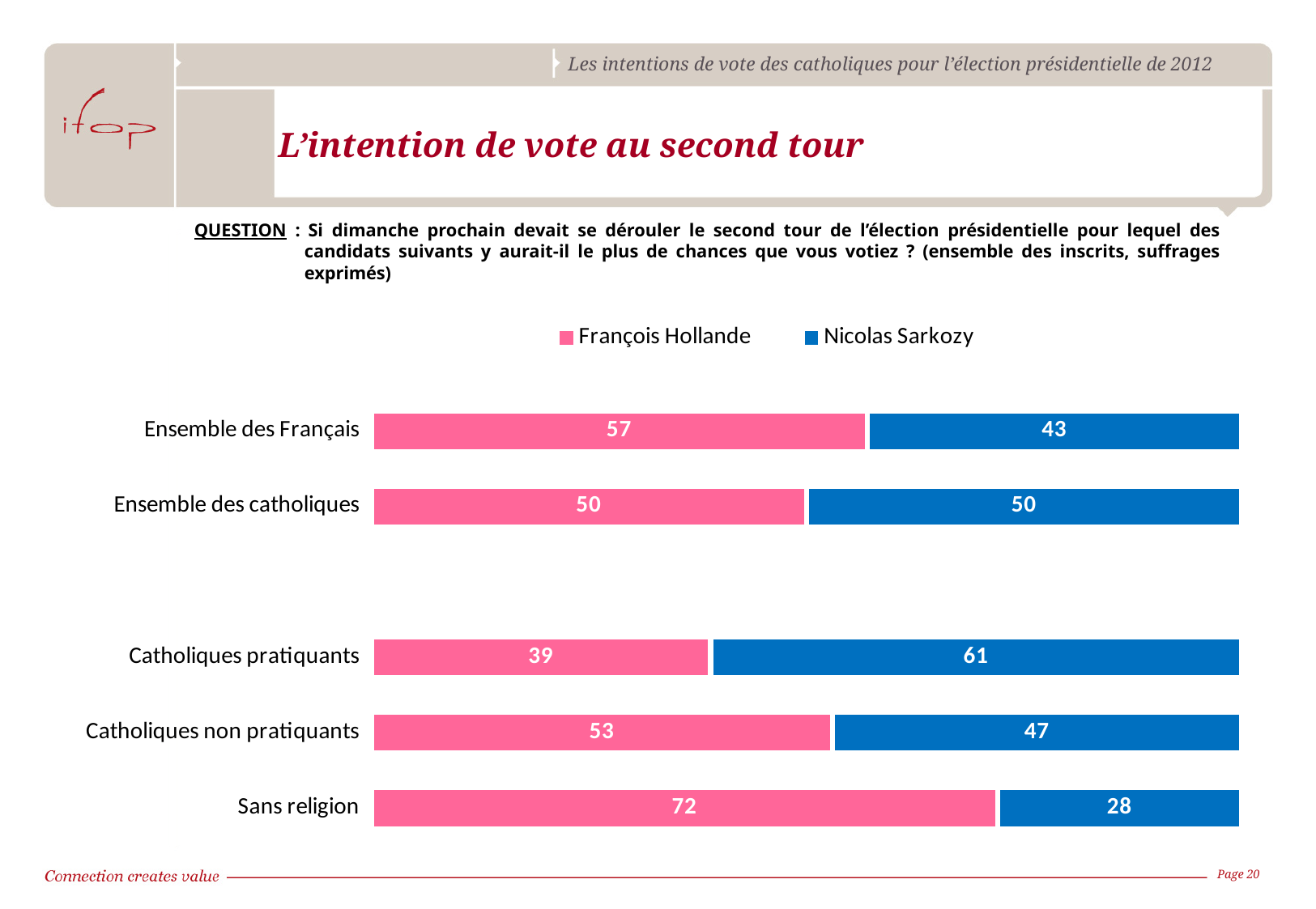
What is the value for Nicolas Sarkozy among Catholiques non pratiquants? 47 What is the total of the stacked bar for Catholiques non pratiquants? 100 What is the difference between Nicolas Sarkozy and François Hollande among Catholiques pratiquants? 22 How many series does the legend list? 2 What is the value for François Hollande among Ensemble des Français? 57 What kind of chart is shown on the slide? Stacked bar chart Which category has the lowest value for Nicolas Sarkozy? Sans religion How many categories are shown in the chart? 5 What is the value for Nicolas Sarkozy among Catholiques pratiquants? 61 What is the value for François Hollande among Sans religion? 72 Which category has the highest value for François Hollande? Sans religion Among Ensemble des catholiques, which candidate has the larger value, François Hollande or Nicolas Sarkozy? They are equal (50 each)